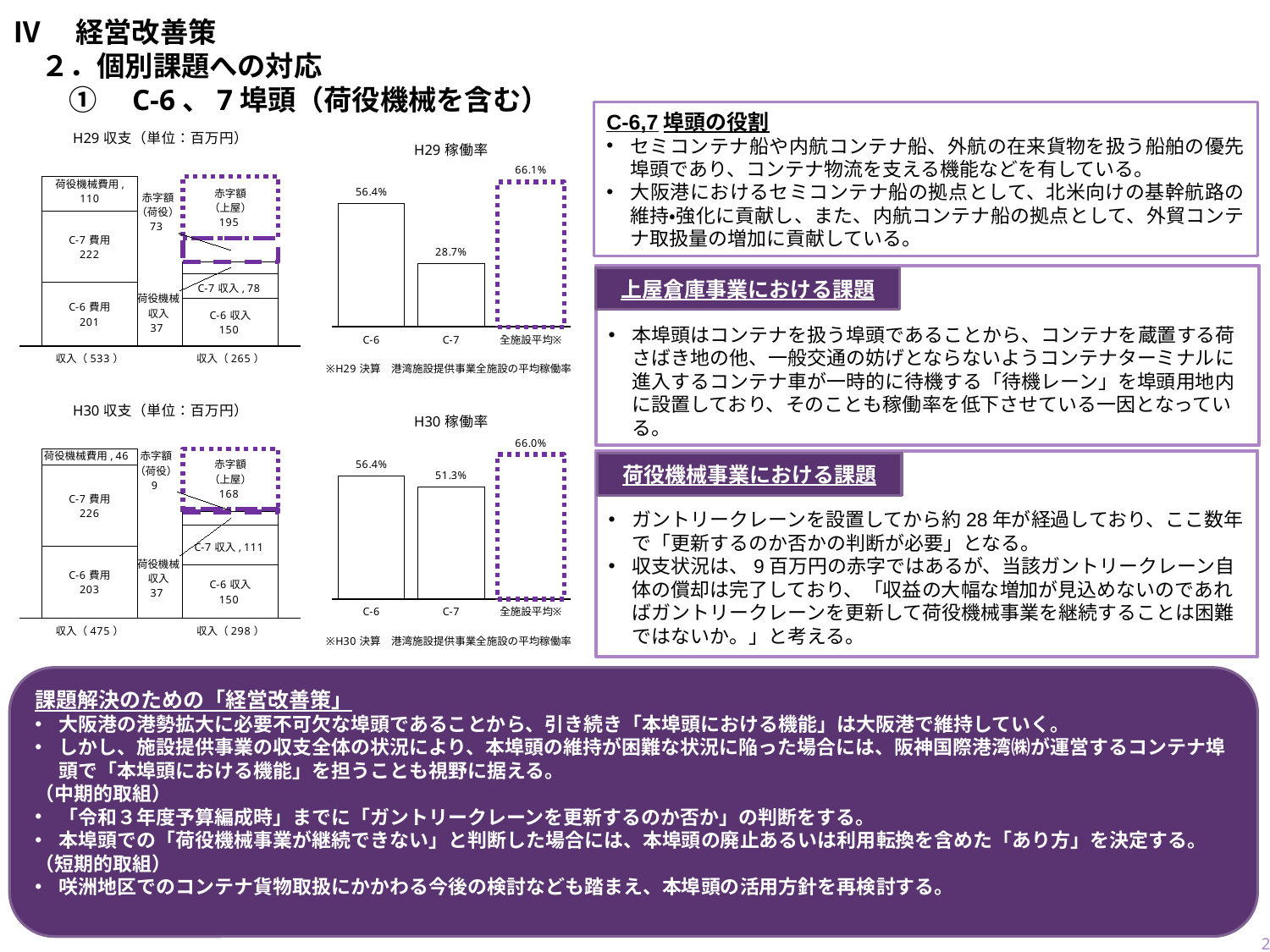
In the H30 稼働率 chart, what is the value for C-7? 51.3% In the H29 稼働率 chart, what is the value for C-7? 28.7% In the H30 稼働率 chart, which category has the lowest value? C-7 In the H29 収支 chart, what is the value of 赤字額（上屋）? 195 In the H30 収支 chart, what is the difference between C-7 費用 and C-6 費用? 23 In the H30 稼働率 chart, which is larger, the value for C-6 or the value for C-7? C-6 In the H30 収支 chart, what is the value of 荷役機械費用? 46 In the H29 収支 chart, what is the value of C-7 費用? 222 In the H29 稼働率 chart, what is the difference between the 全施設平均 value and the C-6 value? 9.7% What kind of chart is the H29 稼働率 chart? Bar chart How many categories are shown on the x axis of the H30 稼働率 chart? 3 In the H29 稼働率 chart, which category has the highest value? 全施設平均